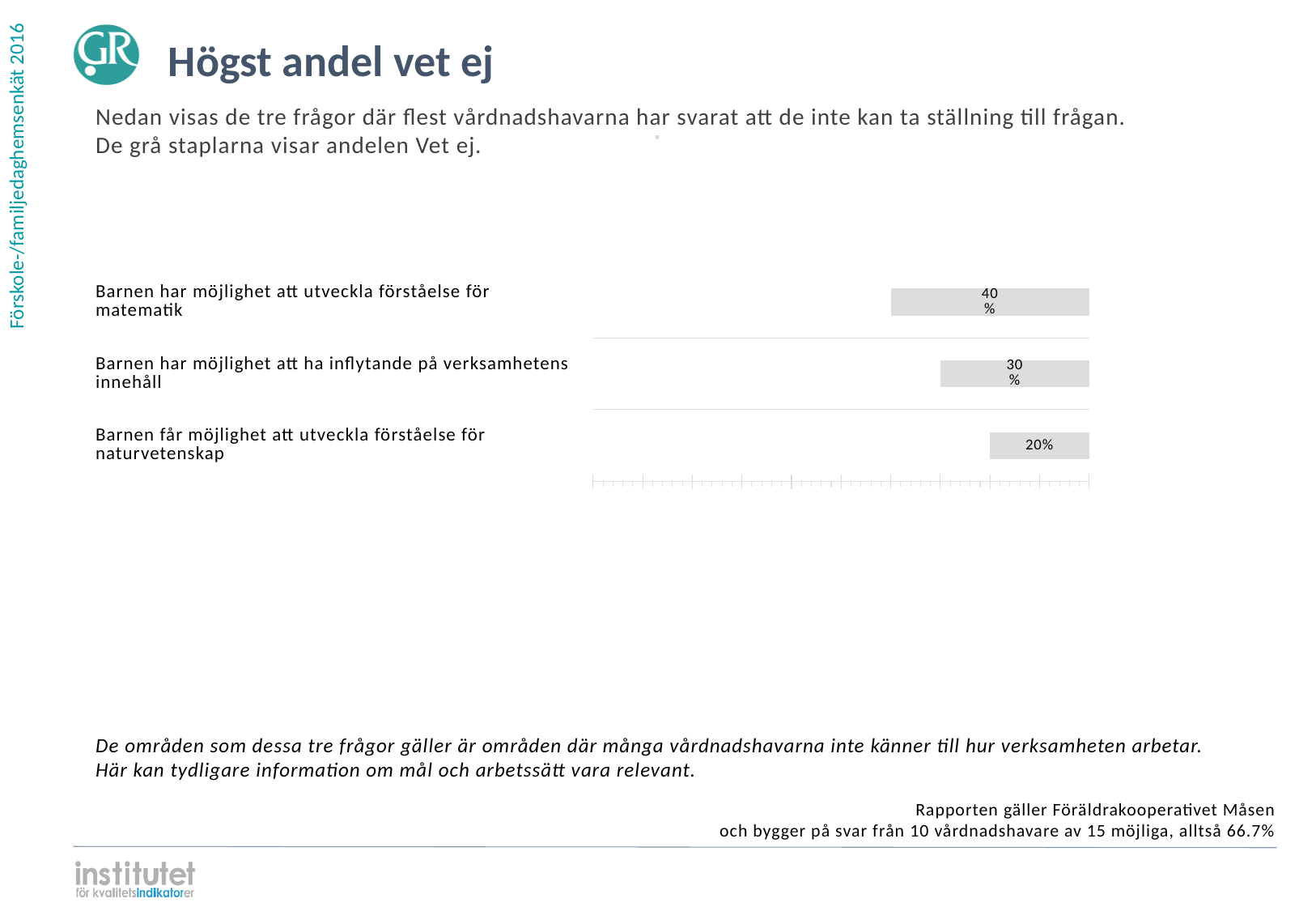
What is the difference between the 'Vet ej' share for the matematik question and the naturvetenskap question? 20% What is the title of the slide containing the chart? Högst andel vet ej What is the 'Vet ej' share for 'Barnen har möjlighet att utveckla förståelse för matematik'? 40% What colour are the bars in the chart? Grey What is the difference between the 'Vet ej' share for the matematik question and the inflytande question? 10% What is the 'Vet ej' share for 'Barnen har möjlighet att ha inflytande på verksamhetens innehåll'? 30% Which question has the lowest 'Vet ej' share? Barnen får möjlighet att utveckla förståelse för naturvetenskap How many questions (categories) are shown in the chart? 3 Which has a larger 'Vet ej' share: the inflytande question or the naturvetenskap question? Barnen har möjlighet att ha inflytande på verksamhetens innehåll What kind of chart is shown on the slide? Bar chart Which question has the highest 'Vet ej' share? Barnen har möjlighet att utveckla förståelse för matematik What is the 'Vet ej' share for 'Barnen får möjlighet att utveckla förståelse för naturvetenskap'? 20%